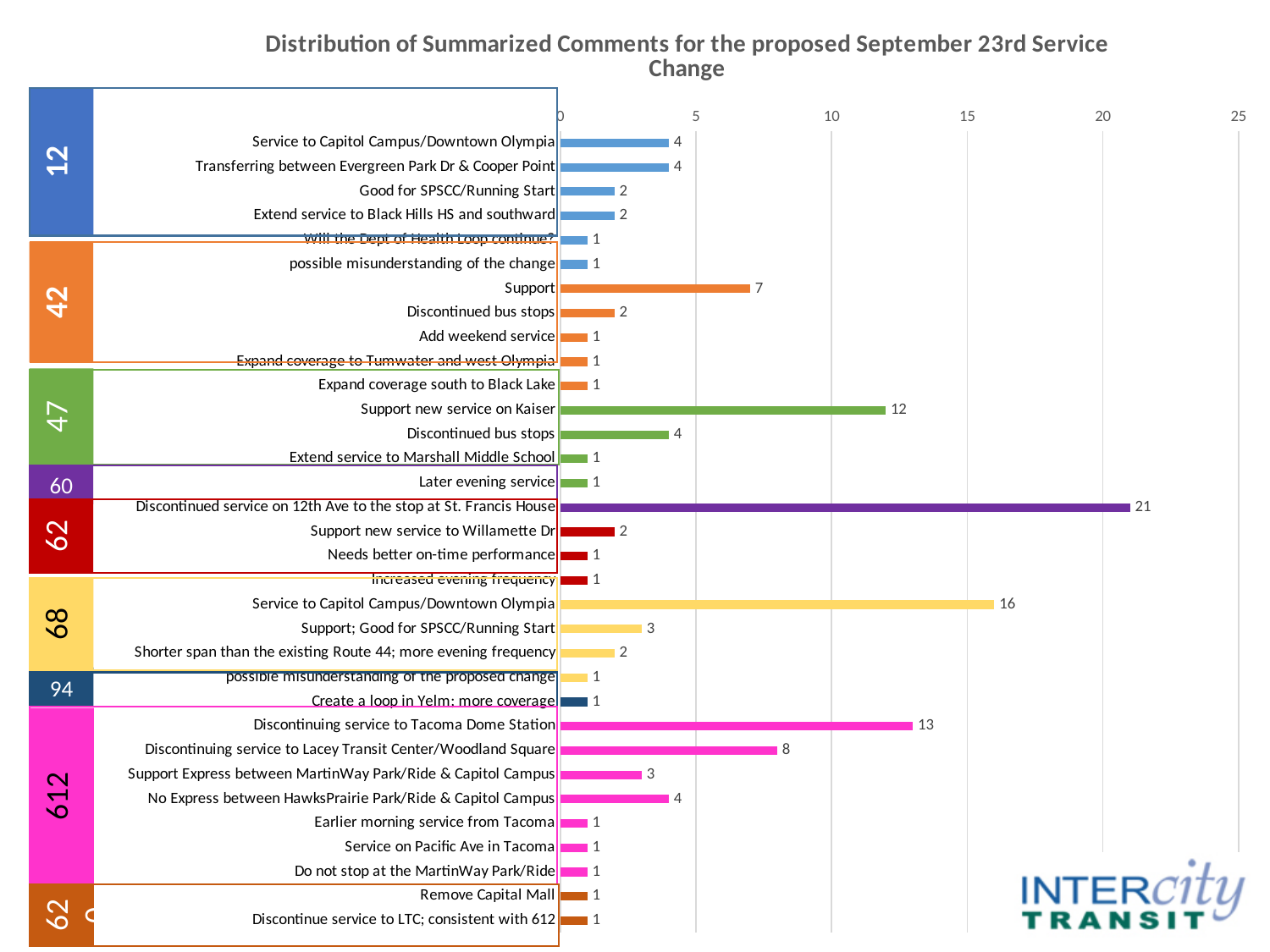
What is the title of the chart? Distribution of Summarized Comments for the proposed September 23rd Service Change What is the value for "Discontinuing service to Tacoma Dome Station"? 13 Which comment category has the highest value? Discontinued service on 12th Ave to the stop at St. Francis House What is the value for "No Express between HawksPrairie Park/Ride & Capitol Campus"? 4 Is the value for "Service to Capitol Campus/Downtown Olympia" in the route 68 group greater or less than 15? greater What is the value for "Discontinuing service to Lacey Transit Center/Woodland Square"? 8 What is the difference between the values for "Discontinued service on 12th Ave to the stop at St. Francis House" and "Service to Capitol Campus/Downtown Olympia" in the route 68 group? 5 Which is larger, the value for "Discontinuing service to Tacoma Dome Station" or the value for "Support new service on Kaiser"? Discontinuing service to Tacoma Dome Station What is the value for "Support" in the route 42 group? 7 What is the value for "Support new service on Kaiser"? 12 What is the value for "Discontinued service on 12th Ave to the stop at St. Francis House"? 21 What type of chart is shown on the slide? bar chart